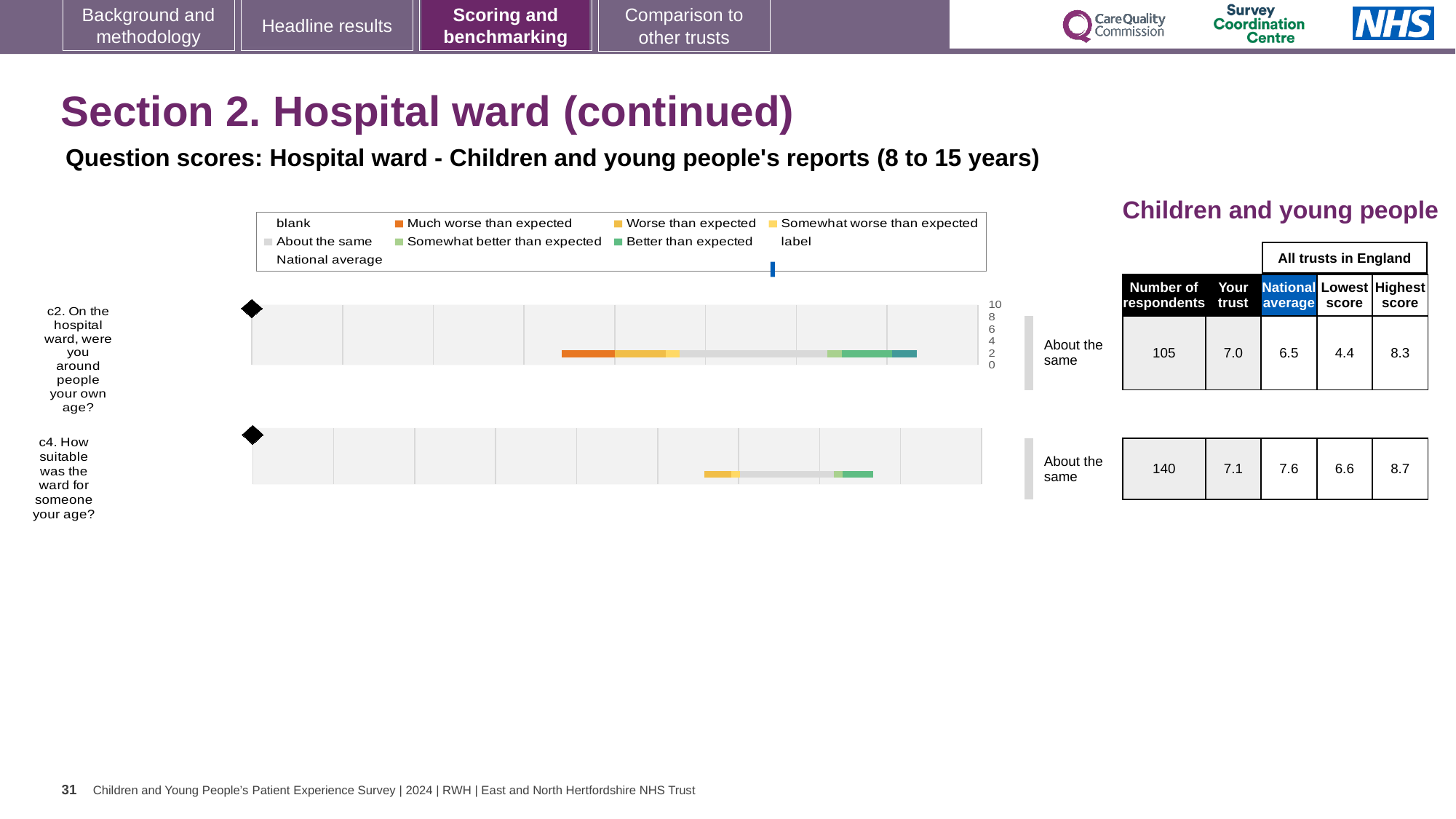
What is the national average score for question c4? 7.6 What benchmark category is shown next to the chart for question c2? About the same What is the 'Your trust' score for question c2 (On the hospital ward, were you around people your own age?)? 7.0 In the legend, which colour represents 'Much worse than expected'? orange What is the difference between the highest score and the lowest score for question c2? 3.9 What benchmark category is shown next to the chart for question c4? About the same How many questions are plotted in the charts on this slide? 2 In the legend, which colour represents 'About the same'? grey What is the 'Your trust' score for question c4 (How suitable was the ward for someone your age?)? 7.1 Which question has the higher 'Your trust' score, c2 or c4? c4 How many respondents answered question c2? 105 What kind of chart is used to show the question scores on this slide? bar chart